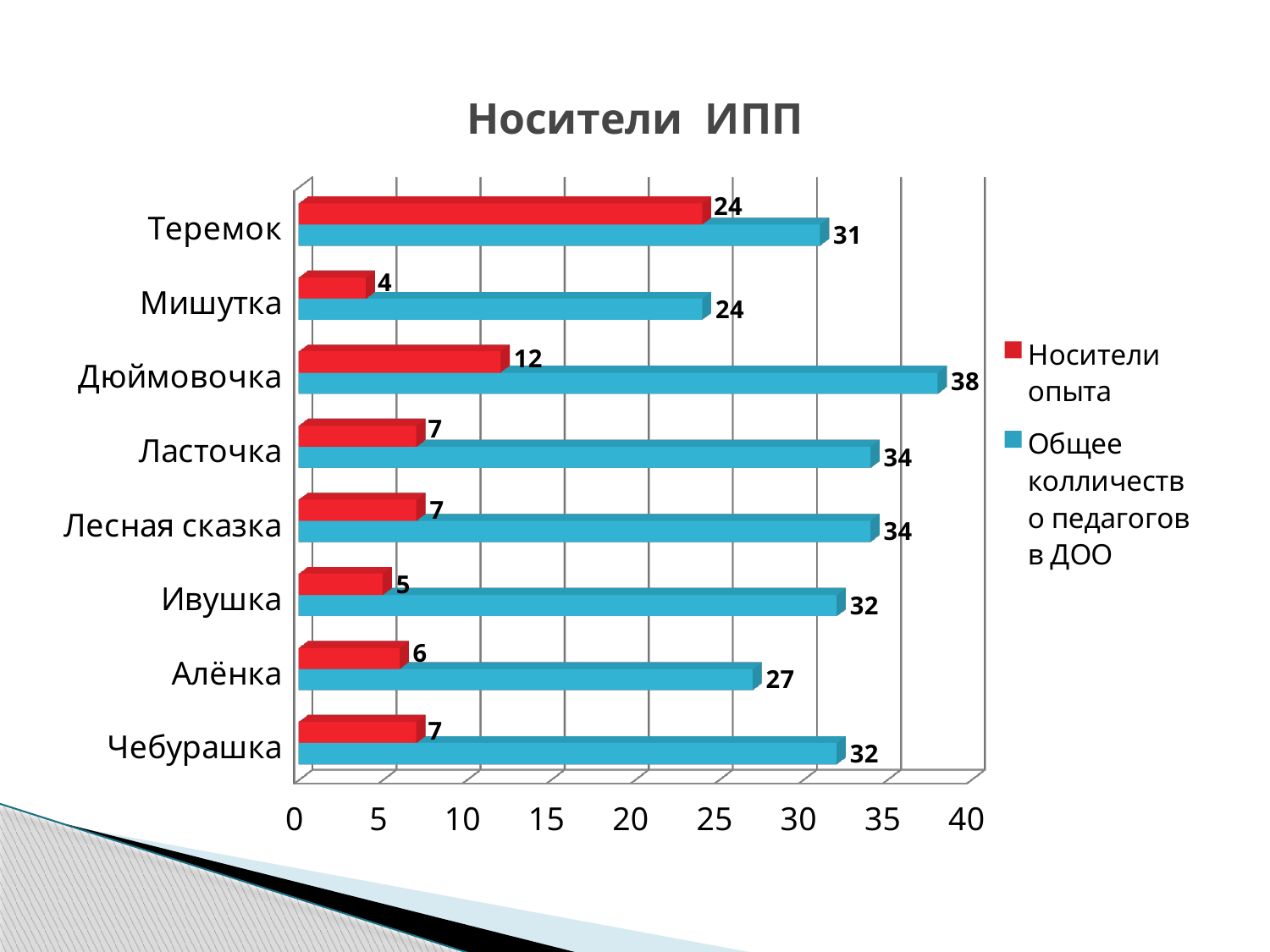
What is the difference between 'Общее колличество педагогов в ДОО' and 'Носители опыта' for Ласточка? 27 Which category has the highest value for 'Общее колличество педагогов в ДОО'? Дюймовочка What is the title of the chart? Носители ИПП How many series does the legend list? 2 What is the value of 'Носители опыта' for Мишутка? 4 What is the value of 'Носители опыта' for Теремок? 24 What kind of chart is shown on the slide? Bar chart Which is larger: 'Общее колличество педагогов в ДОО' for Алёнка or for Ивушка? Ивушка What is the value of 'Общее колличество педагогов в ДОО' for Дюймовочка? 38 How many categories are shown on the chart? 8 Which category has the highest value for 'Носители опыта'? Теремок Which category has the lowest value for 'Носители опыта'? Мишутка